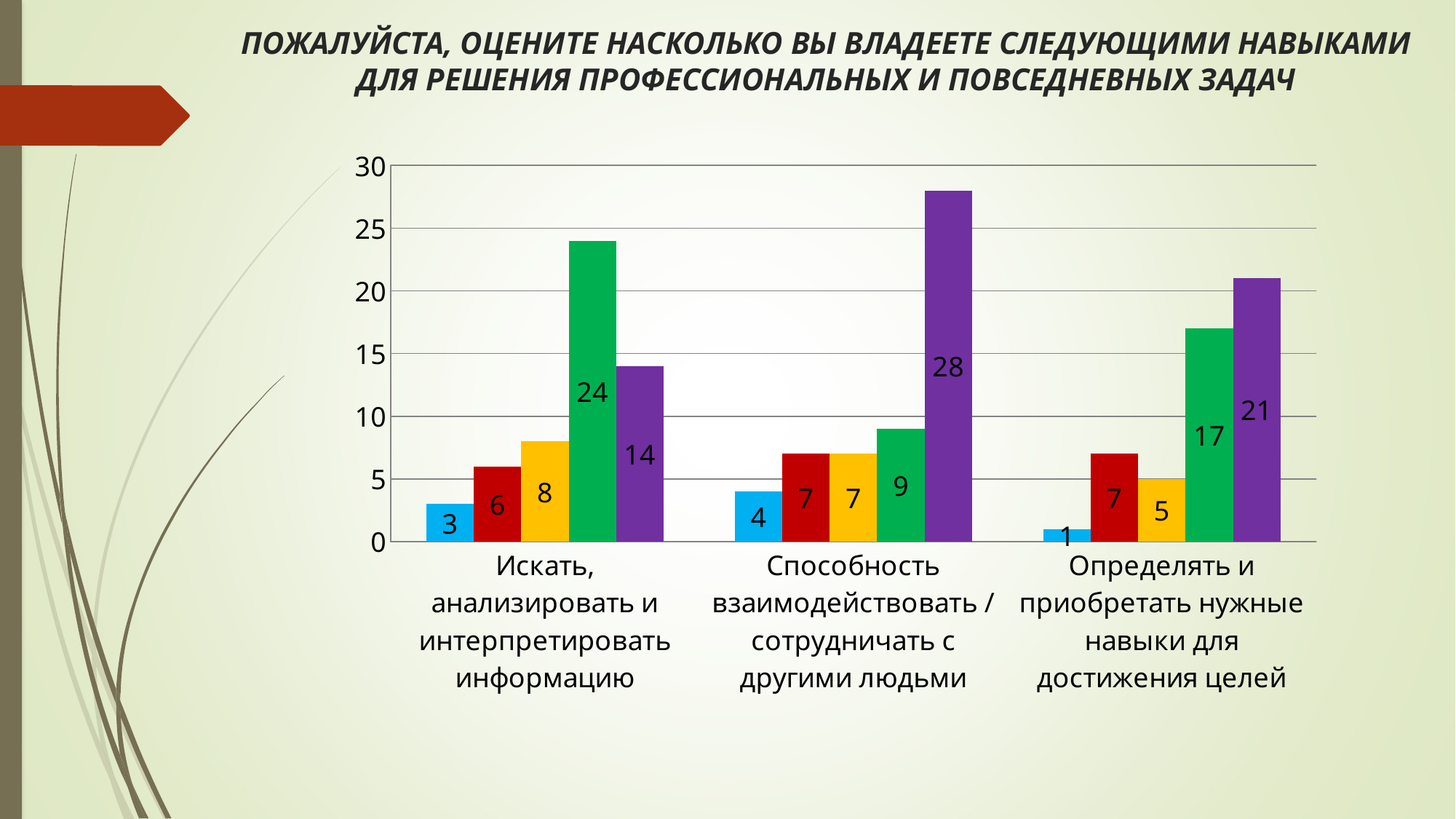
Which bar is the lowest in the whole chart, and what is its value? The blue bar for 'Определять и приобретать нужные навыки для достижения целей', 1 What is the value of the blue bar for the category 'Определять и приобретать нужные навыки для достижения целей'? 1 What is the value of the green bar for the category 'Искать, анализировать и интерпретировать информацию'? 24 What is the value of the purple bar for the category 'Способность взаимодействовать / сотрудничать с другими людьми'? 28 How many bars are plotted for each category in the chart? 5 For the category 'Искать, анализировать и интерпретировать информацию', which is larger: the green bar or the purple bar? the green bar Which bar is the highest in the whole chart, and what is its value? The purple bar for 'Способность взаимодействовать / сотрудничать с другими людьми', 28 How many categories are shown on the x axis of the chart? 3 What is the value of the yellow bar for the category 'Определять и приобретать нужные навыки для достижения целей'? 5 What kind of chart is shown on the slide? bar chart What is the maximum value shown on the vertical axis of the chart? 30 What is the difference between the purple bar and the green bar for the category 'Определять и приобретать нужные навыки для достижения целей'? 4